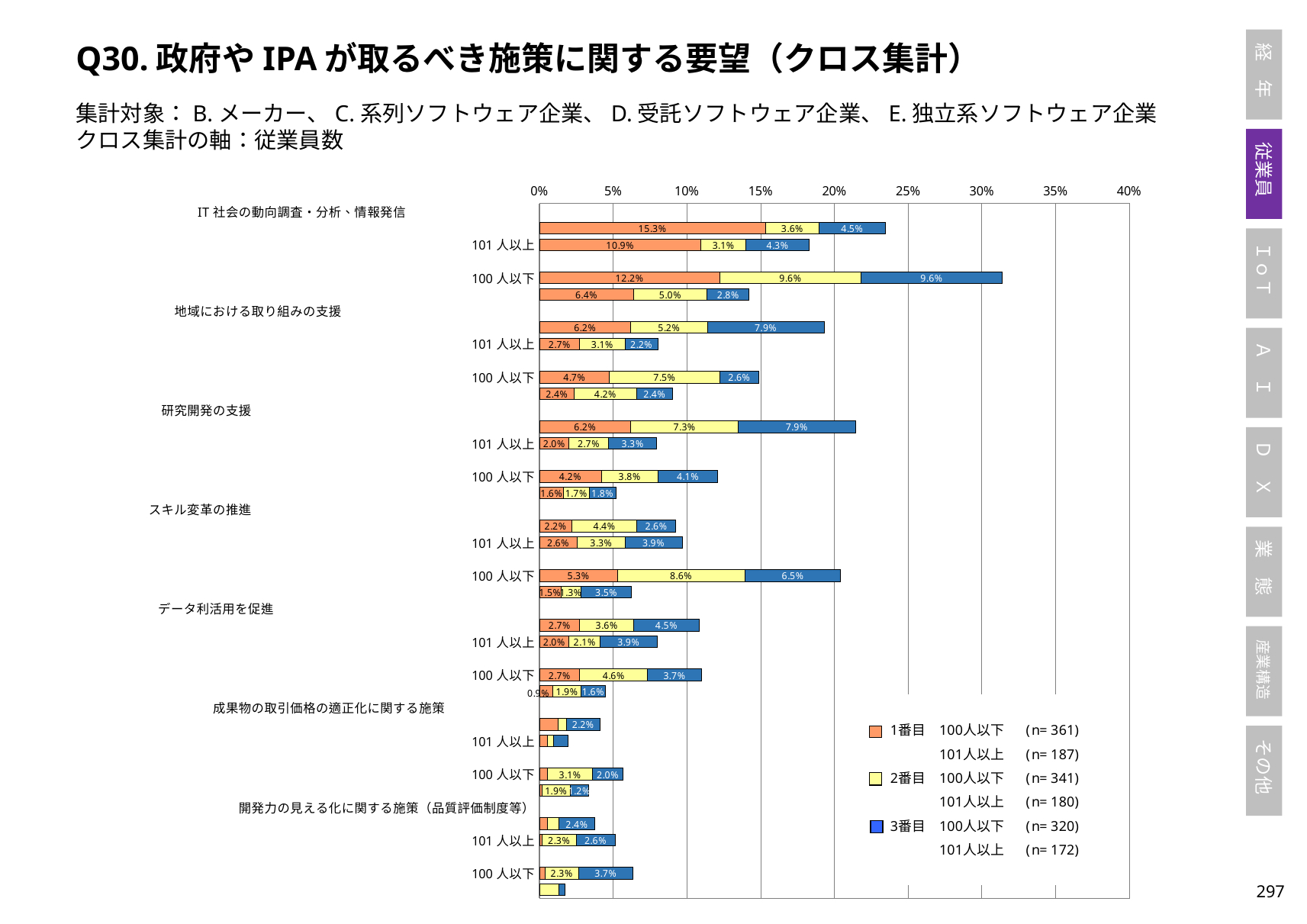
Which is larger: the 1番目 segment labelled 15.3% or the 1番目 segment labelled 12.2%? 15.3% What is the total of the topmost bar, whose segments are labelled 15.3%, 3.6% and 4.5%? 23.4% Is the longest bar in the chart greater or less than 30%? greater What is the total of the longest bar, whose segments are labelled 12.2%, 9.6% and 9.6%? 31.4% What is the difference between the 1番目 segments labelled 15.3% and 12.2%? 3.1% According to the legend, what is the n for 1番目 100人以下? n= 361 How many series does the legend list? 3 What kind of chart is shown on the slide? Stacked horizontal bar chart According to the legend, what is the n for 3番目 101人以上? n= 172 What is the maximum value shown on the horizontal axis? 40% What is the largest single data label printed on any bar segment? 15.3% Is the topmost bar (15.3%, 3.6%, 4.5%) greater or less than 20%? greater